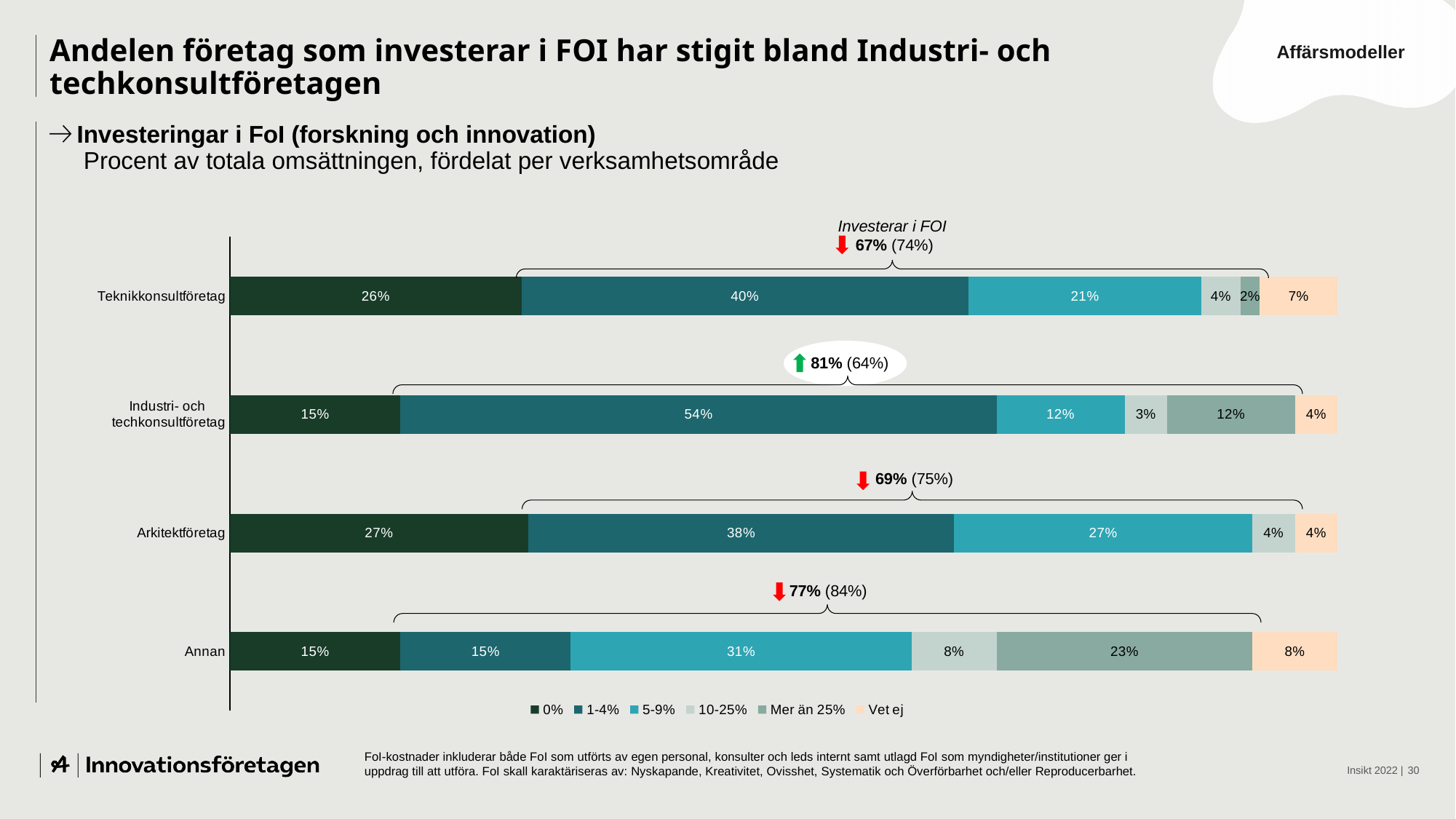
What is the difference between the 5-9% values for Annan and Arkitektföretag? 4% What is the value of the 1-4% segment for Industri- och techkonsultföretag? 54% What type of chart is shown on the slide? Stacked bar chart What is the value of the 0% segment for Teknikkonsultföretag? 26% Which category has the highest value in the 1-4% series? Industri- och techkonsultföretag How many series does the legend list? 6 What is the value of the Vet ej segment for Teknikkonsultföretag? 7% How many categories (verksamhetsområden) are shown on the y axis? 4 Which category has the lowest value in the 5-9% series? Industri- och techkonsultföretag What share of Industri- och techkonsultföretag is annotated as 'Investerar i FOI'? 81% Which is larger: the 0% segment for Arkitektföretag or the 0% segment for Teknikkonsultföretag? Arkitektföretag What is the value of the Mer än 25% segment for Annan? 23%